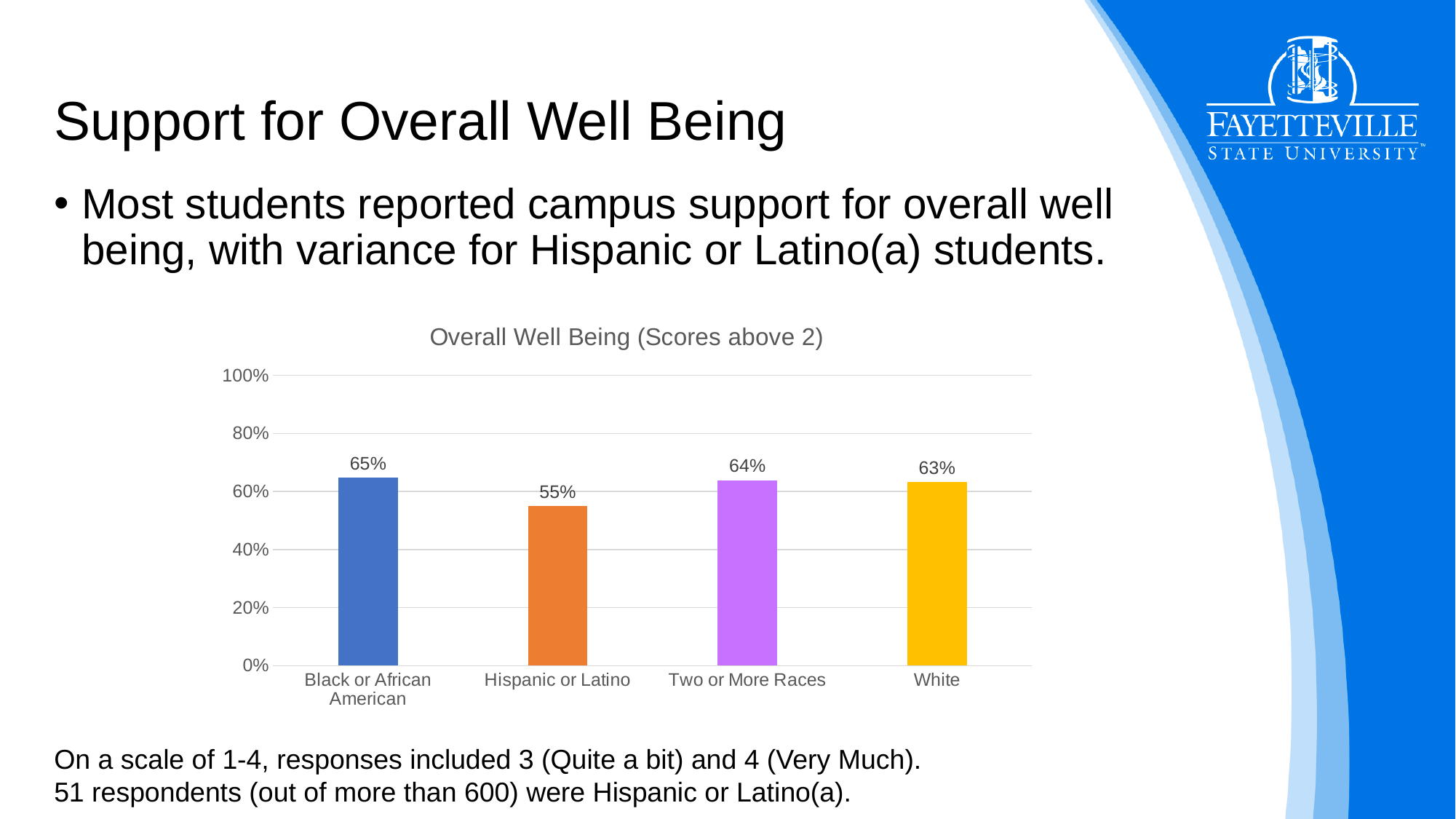
Which is larger, the value for Hispanic or Latino or the value for White? White What kind of chart is shown on the slide? Bar chart What is the value for Black or African American? 65% What is the title of the chart? Overall Well Being (Scores above 2) What is the value for White? 63% What is the difference between the values for Black or African American and Hispanic or Latino? 10% Which category has the lowest value? Hispanic or Latino What is the difference between the values for Two or More Races and White? 1% How many categories are shown in the chart? 4 What is the value for Two or More Races? 64% Which category has the highest value? Black or African American What is the value for Hispanic or Latino? 55%